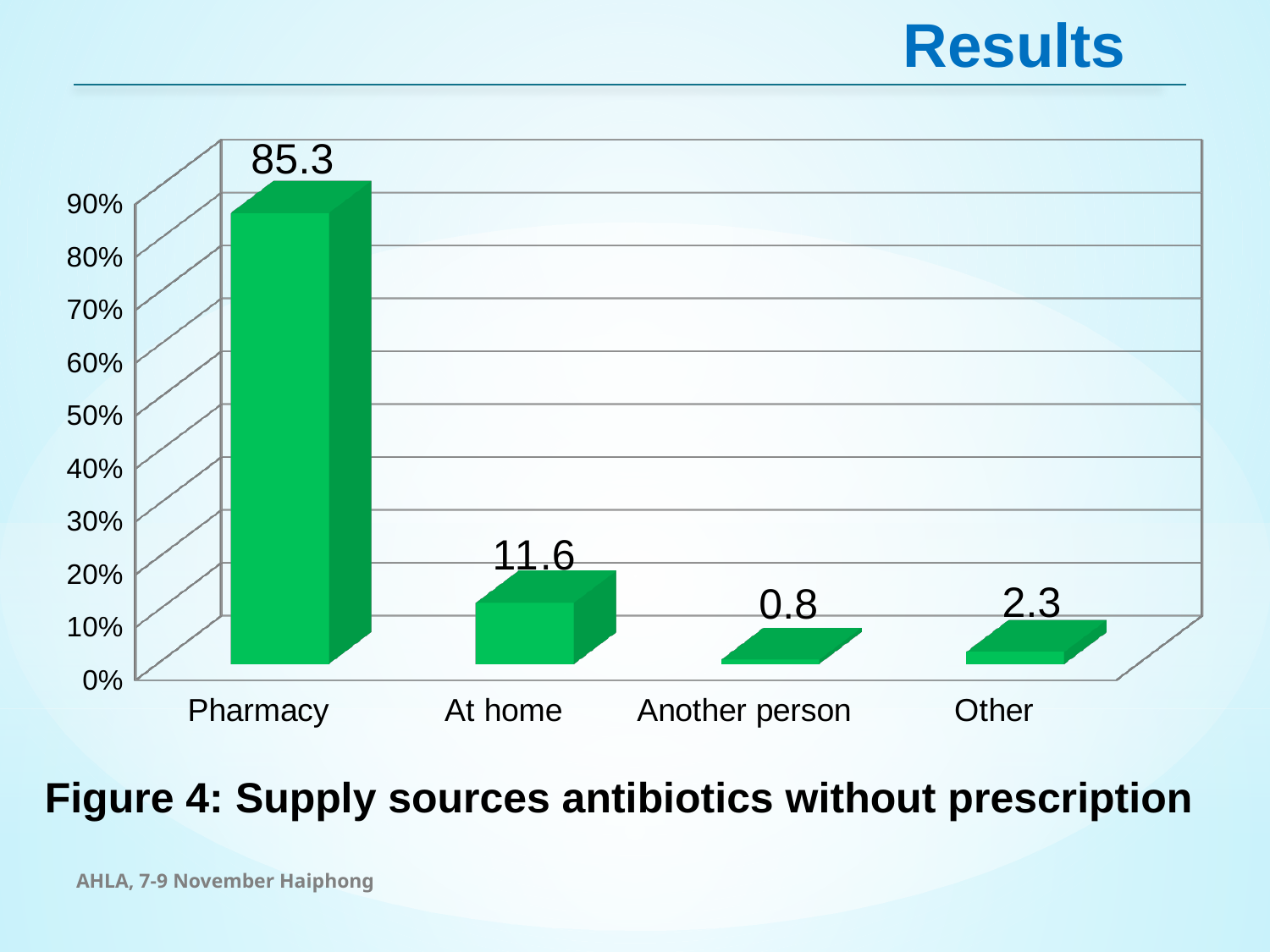
What kind of chart is shown on the slide? Bar chart What is the caption of the figure shown on the slide? Figure 4: Supply sources antibiotics without prescription What is the difference between the values for Pharmacy and At home? 73.7 What is the value for Pharmacy? 85.3 What is the difference between the values for Other and Another person? 1.5 What is the value for Another person? 0.8 What is the value for Other? 2.3 Which is larger, the value for At home or the value for Other? At home What is the value for At home? 11.6 How many categories are shown on the x axis? 4 Which category has the lowest value? Another person Which category has the highest value? Pharmacy